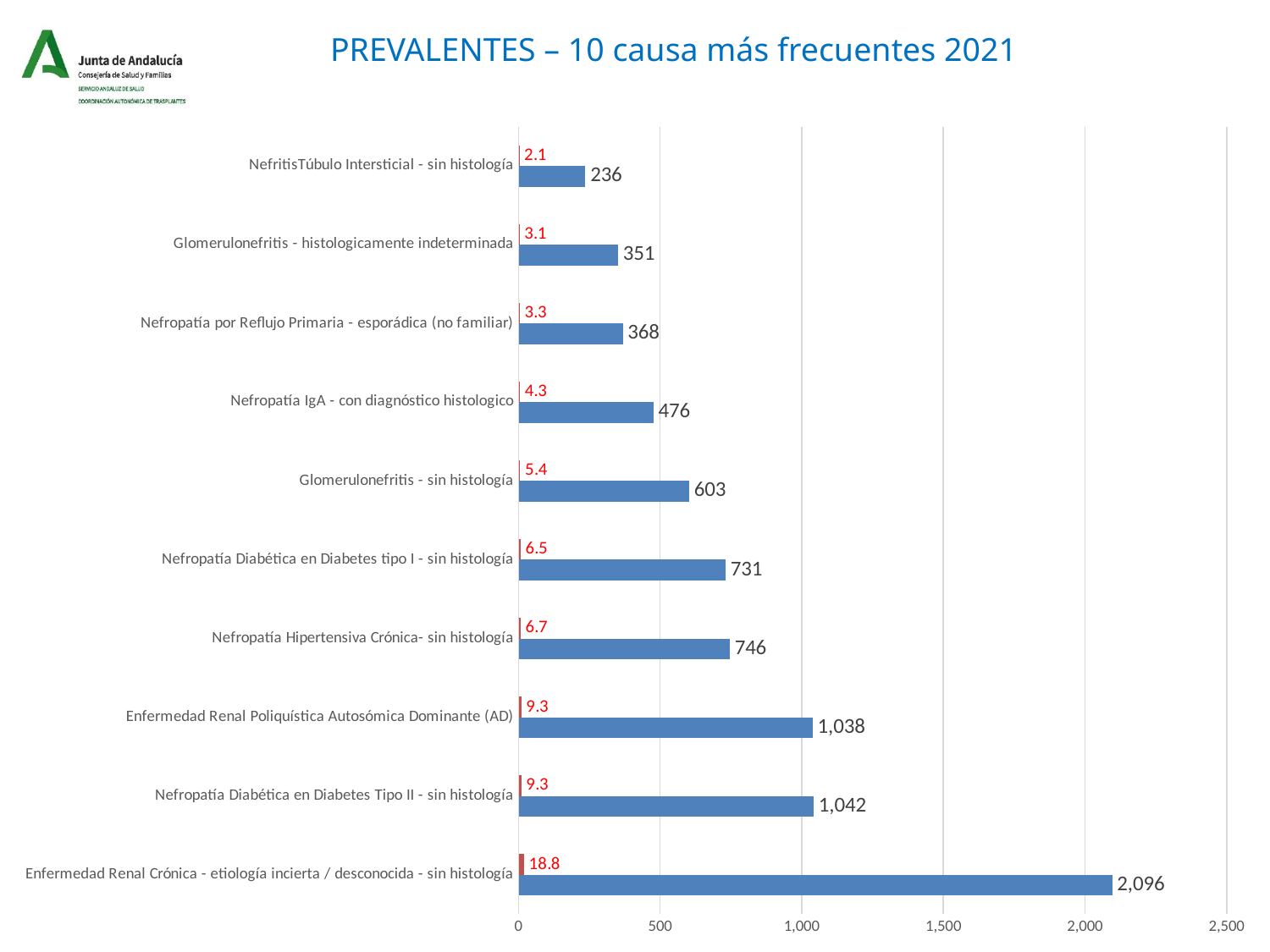
What is the red value shown for "Glomerulonefritis - histologicamente indeterminada"? 3.1 Which category has the lowest blue bar value? NefritisTúbulo Intersticial - sin histología Which category has the highest blue bar value? Enfermedad Renal Crónica - etiología incierta / desconocida - sin histología Is the blue bar value for "Nefropatía IgA - con diagnóstico histologico" greater or less than 500? less What is the value of the blue bar for "Glomerulonefritis - sin histología"? 603 What kind of chart is shown on the slide? bar chart What is the red value shown for "Nefropatía IgA - con diagnóstico histologico"? 4.3 How many categories are shown on the chart? 10 What is the title of the chart? PREVALENTES – 10 causa más frecuentes 2021 Which has a larger blue bar value: "Nefropatía Hipertensiva Crónica- sin histología" or "Nefropatía Diabética en Diabetes tipo I - sin histología"? Nefropatía Hipertensiva Crónica- sin histología What is the difference between the blue bar values for "Nefropatía Diabética en Diabetes Tipo II - sin histología" and "Enfermedad Renal Poliquística Autosómica Dominante (AD)"? 4 What is the value of the blue bar for "Enfermedad Renal Crónica - etiología incierta / desconocida - sin histología"? 2,096